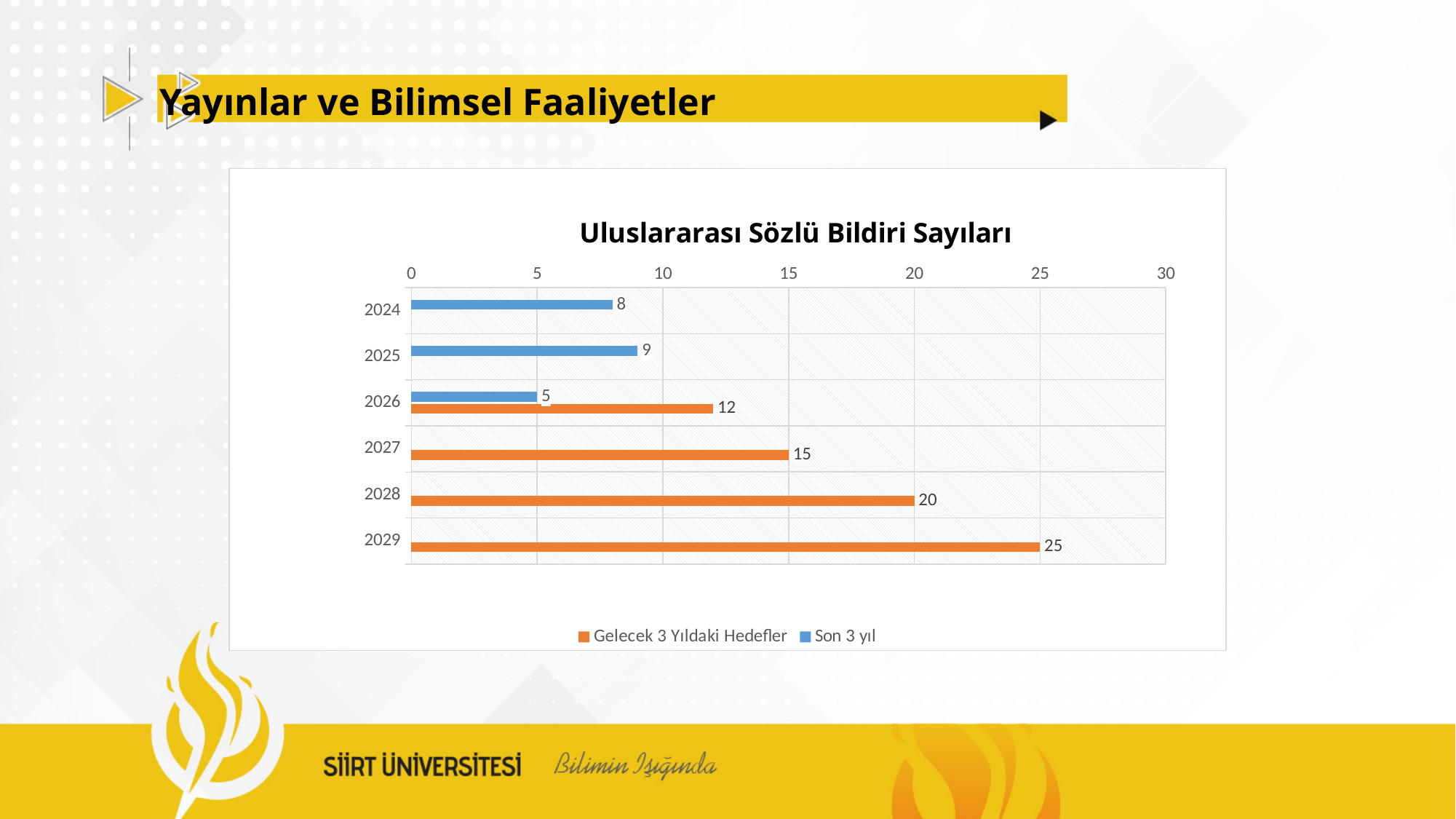
What is the value for 2024 in the 'Son 3 yıl' series? 8 How many years are shown on the vertical axis of the chart? 6 Which year has the highest 'Son 3 yıl' value? 2025 For 2026, which is larger: the 'Son 3 yıl' value or the 'Gelecek 3 Yıldaki Hedefler' value? Gelecek 3 Yıldaki Hedefler What is the value for 2029 in the 'Gelecek 3 Yıldaki Hedefler' series? 25 Which year has the lowest 'Gelecek 3 Yıldaki Hedefler' value? 2026 How many series does the legend list? 2 What type of chart is shown on the slide? Bar chart What is the 'Gelecek 3 Yıldaki Hedefler' value for 2027? 15 What is the difference between the 'Gelecek 3 Yıldaki Hedefler' values for 2029 and 2028? 5 What is the 'Son 3 yıl' value for 2026? 5 Is the 'Gelecek 3 Yıldaki Hedefler' value for 2028 greater or less than 15? greater